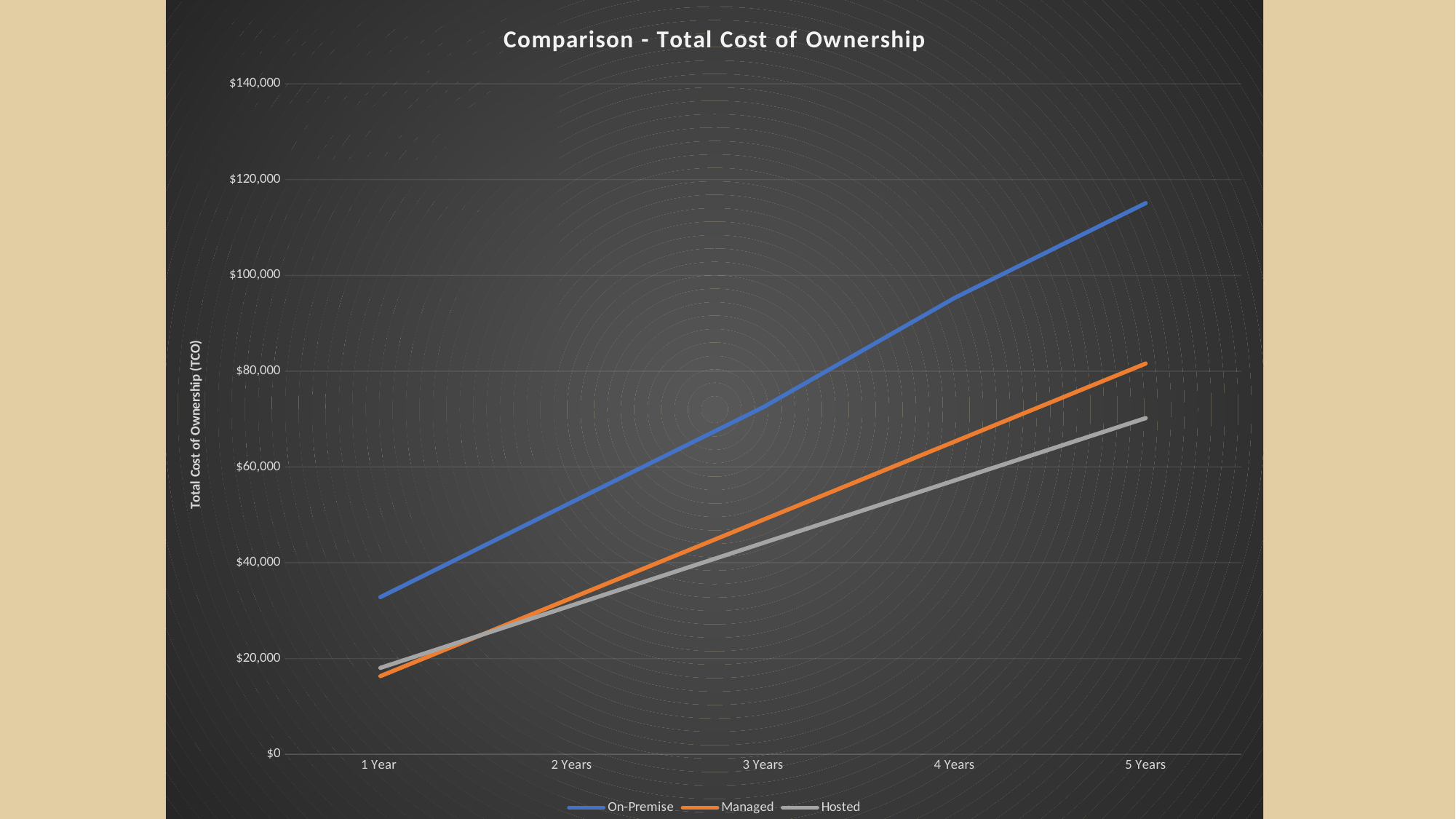
At 5 Years, which is larger: Managed or Hosted? Managed Is the value for Hosted at 5 Years greater or less than $80,000? less How many series does the legend list? 3 What is the title of the chart? Comparison - Total Cost of Ownership Is the value for Hosted at 3 Years greater or less than $60,000? less Which series has the lowest value at 5 Years? Hosted Do the values for On-Premise rise or fall from 1 Year to 5 Years? Rise How many points are there along the x axis? 5 Is the value for On-Premise at 5 Years greater or less than $100,000? greater What kind of chart is shown on the slide? Line chart Which series has the highest value at 5 Years? On-Premise